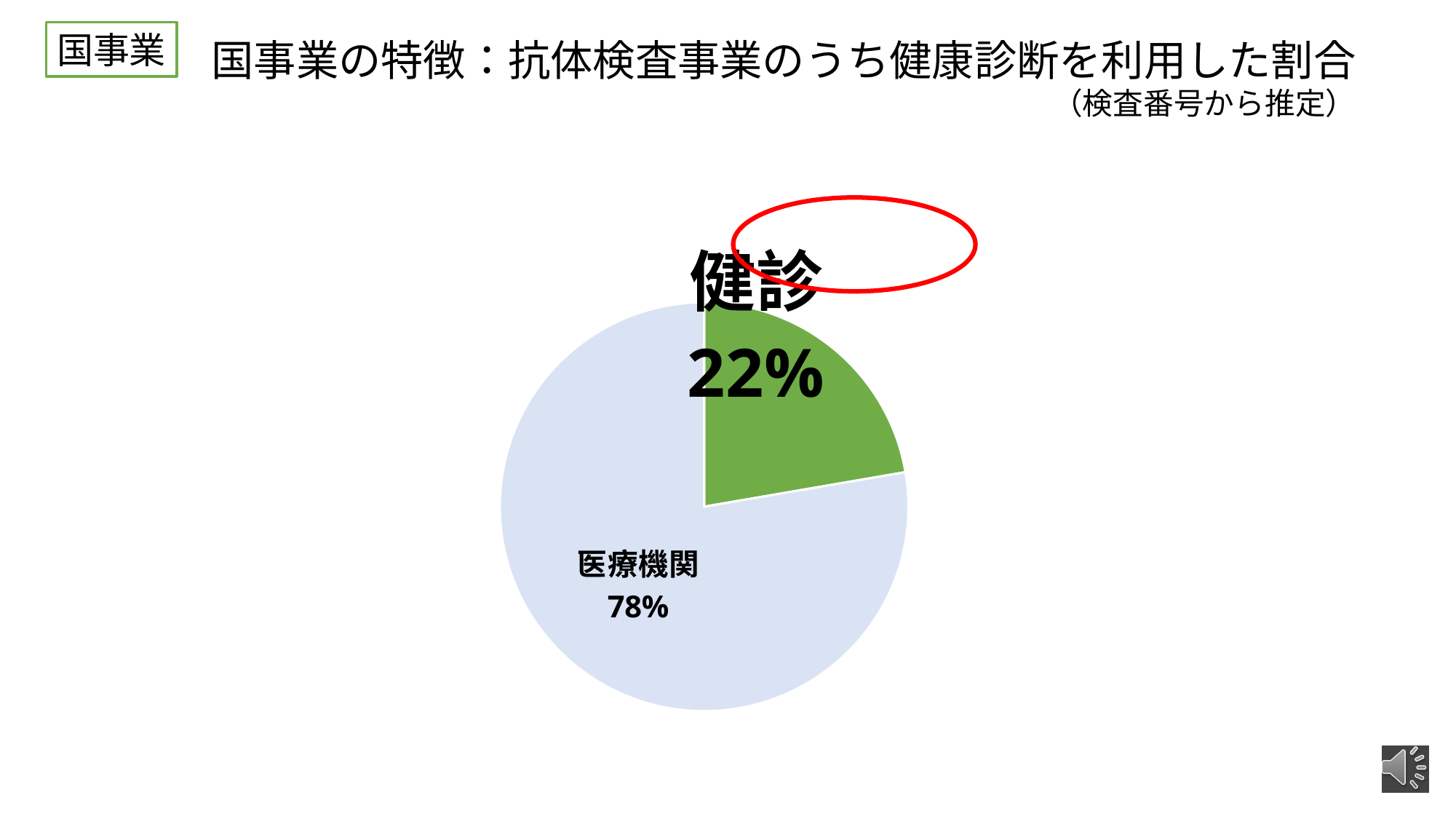
Which slice of the pie is the largest? 医療機関 Which is larger, the 健診 slice or the 医療機関 slice? 医療機関 What is the difference in percentage points between the 医療機関 slice and the 健診 slice? 56 Is the share for 健診 greater or less than 50%? less What share of the pie does 医療機関 account for? 78% What share of the pie does 健診 account for? 22% Which slice of the pie is the smallest? 健診 How many slices does the pie chart have? 2 What is the title of the slide above the chart? 国事業の特徴：抗体検査事業のうち健康診断を利用した割合 What kind of chart is shown on the slide? Pie chart What colour is the 健診 slice of the pie? Green